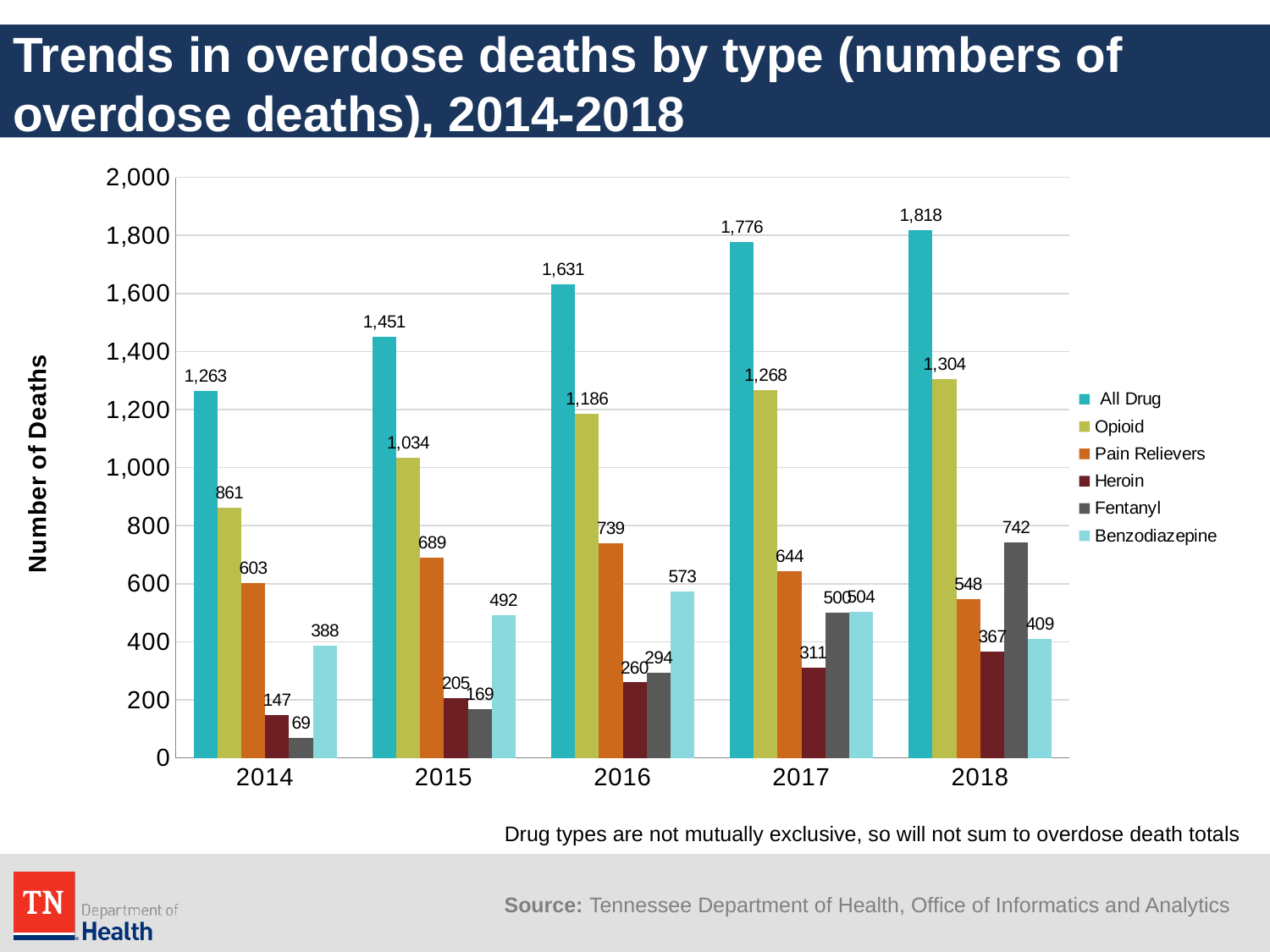
How many series does the legend list? 6 In which year is the Fentanyl value lowest? 2014 What is the number of All Drug overdose deaths in 2018? 1,818 What is the difference between the Opioid values for 2018 and 2017? 36 What is the number of Heroin overdose deaths in 2017? 311 Do the Opioid values rise or fall from 2014 to 2018? rise What kind of chart is shown on the slide? bar chart How many years are shown on the x axis? 5 What is the difference between the All Drug values for 2018 and 2014? 555 Which year has the larger Pain Relievers value, 2016 or 2018? 2016 What is the number of Fentanyl overdose deaths in 2014? 69 In which year is the All Drug value highest? 2018